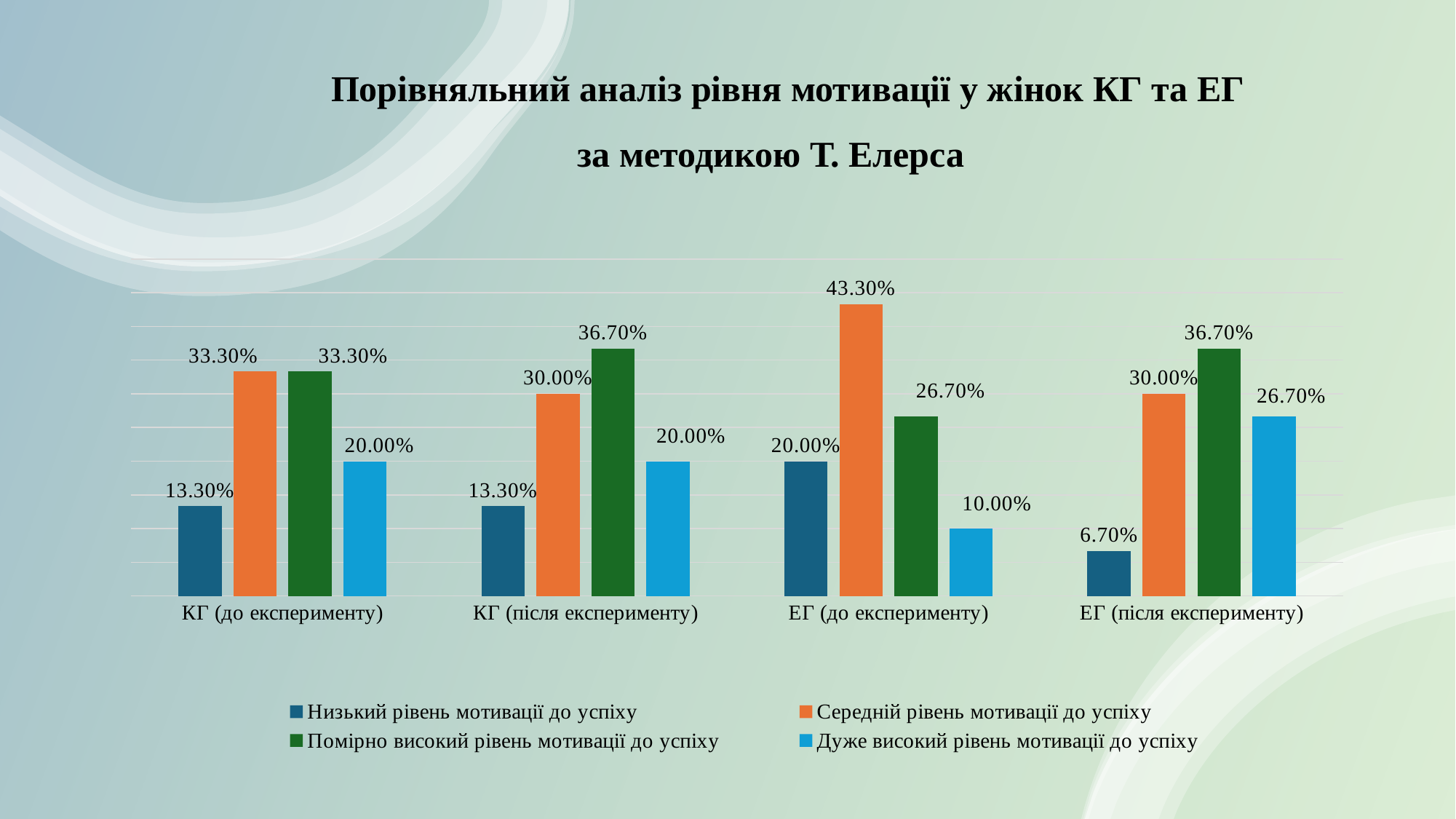
How many series does the legend list? 4 Which category has the highest value for 'Середній рівень мотивації до успіху'? ЕГ (до експерименту) What is the value for 'Середній рівень мотивації до успіху' in 'ЕГ (до експерименту)'? 43.30% What is the value for 'Дуже високий рівень мотивації до успіху' in 'ЕГ (до експерименту)'? 10.00% What is the value for 'Помірно високий рівень мотивації до успіху' in 'КГ (після експерименту)'? 36.70% Which is larger in 'КГ (до експерименту)': 'Низький рівень мотивації до успіху' or 'Дуже високий рівень мотивації до успіху'? Дуже високий рівень мотивації до успіху Which series is shown in orange in the legend? Середній рівень мотивації до успіху What is the difference between 'Дуже високий рівень мотивації до успіху' in 'ЕГ (після експерименту)' and in 'ЕГ (до експерименту)'? 16.70% What is the value for 'Низький рівень мотивації до успіху' in 'ЕГ (після експерименту)'? 6.70% How many categories are shown on the x axis? 4 Which category has the lowest value for 'Низький рівень мотивації до успіху'? ЕГ (після експерименту) What type of chart is shown on the slide? bar chart